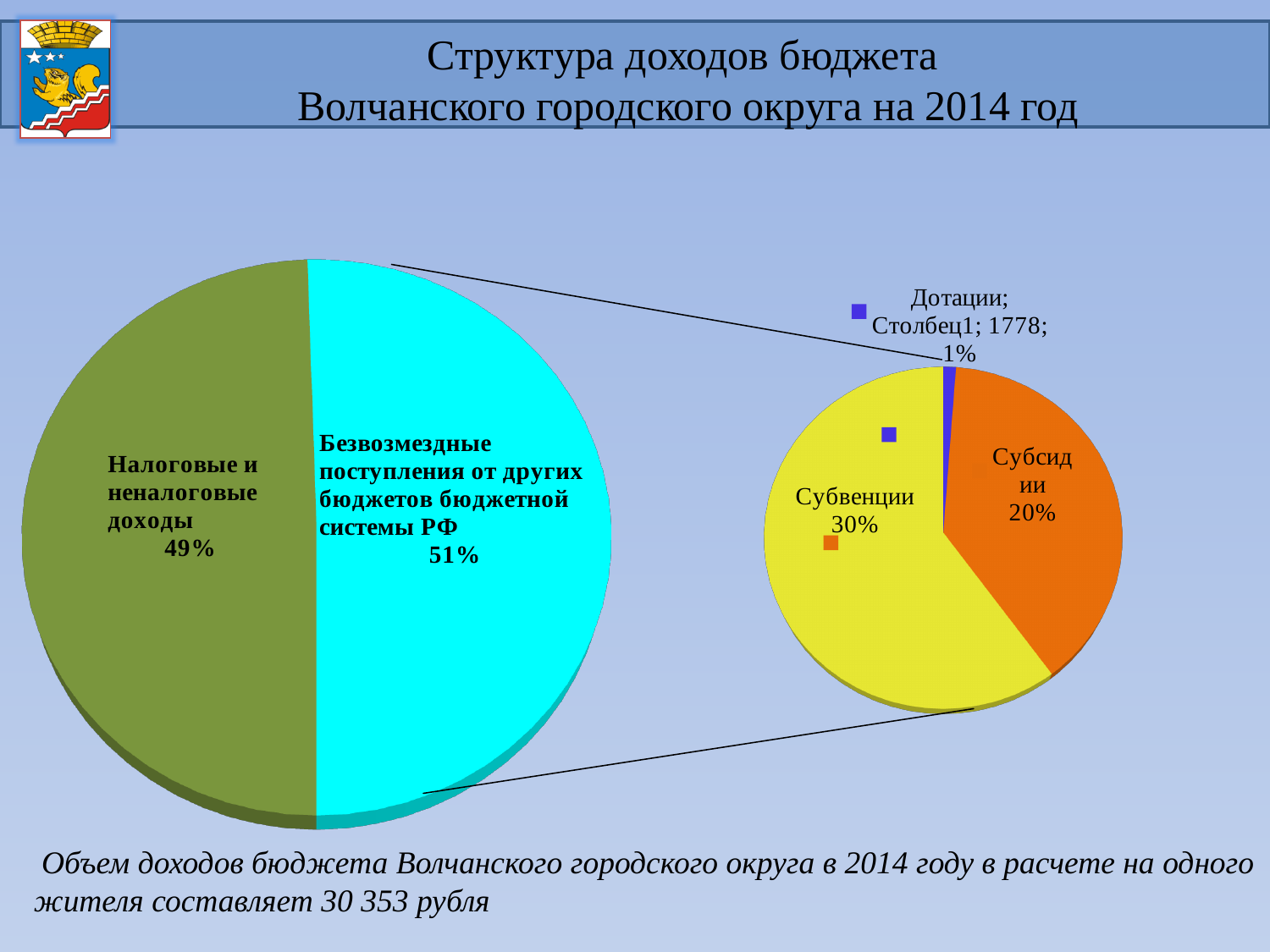
How many slices does the secondary (right) pie have? 3 In the main (left) pie, what share is shown for "Безвозмездные поступления от других бюджетов бюджетной системы РФ"? 51% In the secondary (right) pie, what percentage is shown for "Дотации"? 1% Which is larger in the main pie: "Налоговые и неналоговые доходы" or "Безвозмездные поступления"? Безвозмездные поступления In the main (left) pie, what share is shown for "Налоговые и неналоговые доходы"? 49% What kind of chart is shown on the slide? pie chart In the secondary (right) pie, what percentage is shown for "Субвенции"? 30% Which slice of the secondary (right) pie is the largest? Субвенции What value is printed in the data label for "Дотации" in the secondary pie? 1778 What is the difference in percentage points between "Субвенции" and "Субсидии" in the secondary pie? 10 In the secondary (right) pie, what percentage is shown for "Субсидии"? 20% Which slice of the secondary (right) pie is the smallest? Дотации